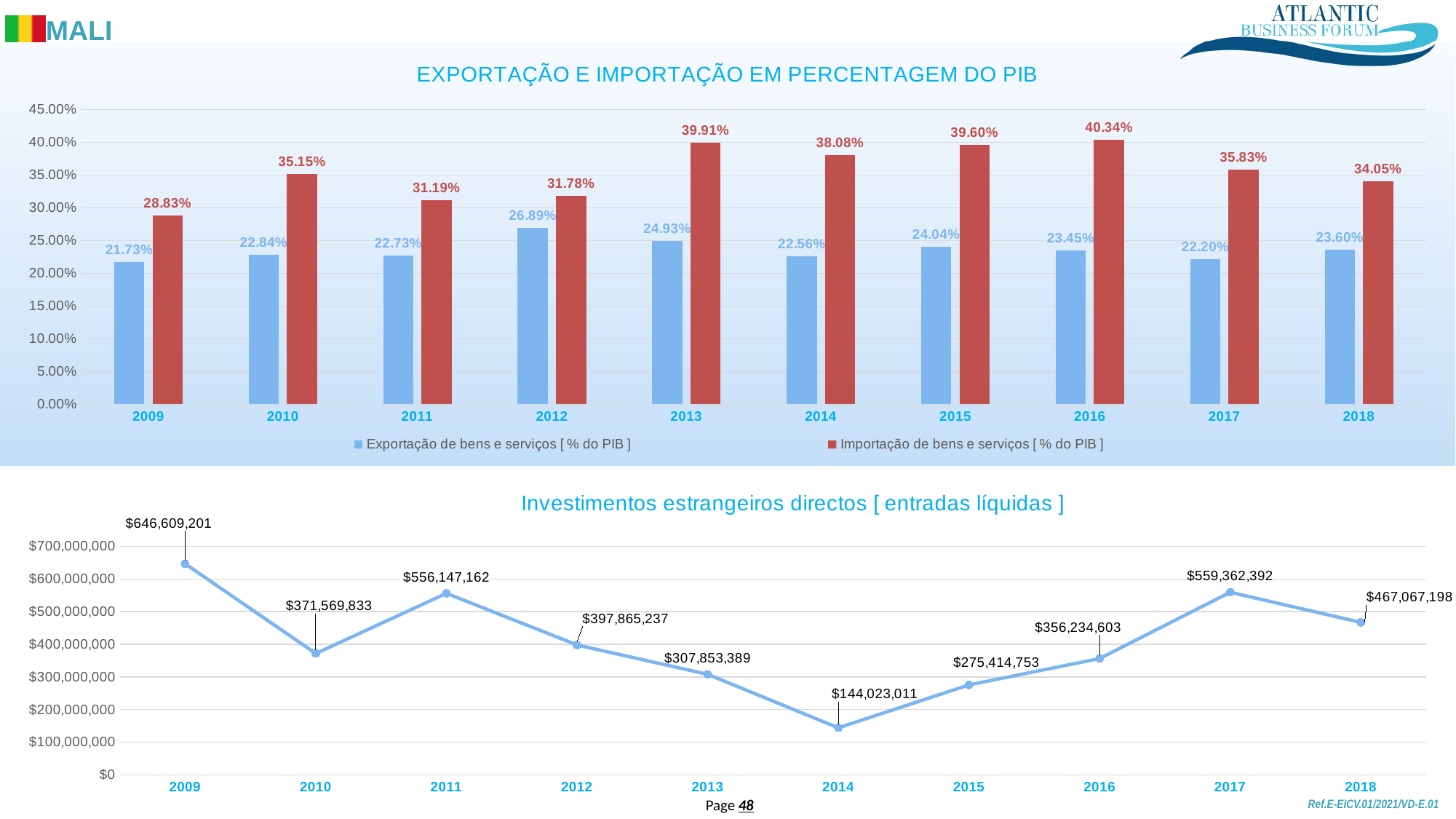
In the chart 'EXPORTAÇÃO E IMPORTAÇÃO EM PERCENTAGEM DO PIB', what is the value of Exportação de bens e serviços for 2012? 26.89% In the chart 'EXPORTAÇÃO E IMPORTAÇÃO EM PERCENTAGEM DO PIB', how many series does the legend list? 2 In the chart 'EXPORTAÇÃO E IMPORTAÇÃO EM PERCENTAGEM DO PIB', which year has the lowest Importação de bens e serviços value? 2009 In the chart 'Investimentos estrangeiros directos [ entradas líquidas ]', what is the value for 2014? $144,023,011 In the chart 'EXPORTAÇÃO E IMPORTAÇÃO EM PERCENTAGEM DO PIB', what is the difference between Importação and Exportação in 2013? 14.98% In the chart 'EXPORTAÇÃO E IMPORTAÇÃO EM PERCENTAGEM DO PIB', what is the value of Importação de bens e serviços for 2016? 40.34% In the chart 'Investimentos estrangeiros directos [ entradas líquidas ]', which year has the highest value? 2009 In the chart 'Investimentos estrangeiros directos [ entradas líquidas ]', what is the difference between the 2017 and 2016 values? $203,127,789 In the chart 'Investimentos estrangeiros directos [ entradas líquidas ]', which is larger, the value for 2011 or the value for 2017? 2017 What kind of chart is 'EXPORTAÇÃO E IMPORTAÇÃO EM PERCENTAGEM DO PIB'? Bar chart How many data points are plotted in the chart 'Investimentos estrangeiros directos [ entradas líquidas ]'? 10 In the chart 'EXPORTAÇÃO E IMPORTAÇÃO EM PERCENTAGEM DO PIB', which year has the highest Exportação de bens e serviços value? 2012